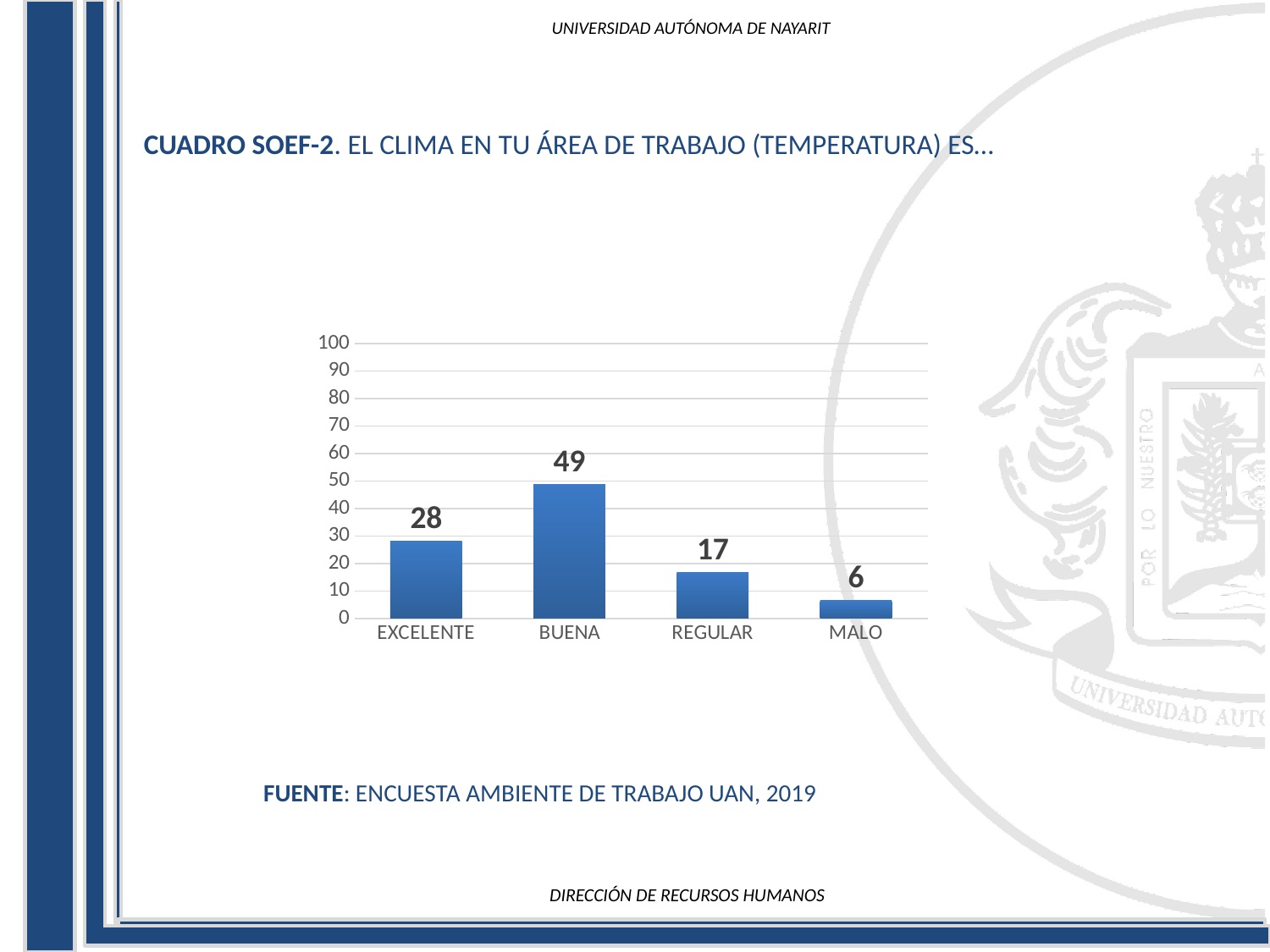
What is the value for REGULAR? 17 What is the value for BUENA? 49 What kind of chart is shown on the slide? Bar chart What is the value for MALO? 6 What is the value for EXCELENTE? 28 What is the difference between the values for REGULAR and MALO? 11 Which category has the highest value? BUENA What is the title of the chart on the slide? CUADRO SOEF-2. EL CLIMA EN TU ÁREA DE TRABAJO (TEMPERATURA) ES… Which is larger, the value for EXCELENTE or the value for REGULAR? EXCELENTE What is the difference between the values for BUENA and EXCELENTE? 21 How many categories are shown on the x axis? 4 Which category has the lowest value? MALO